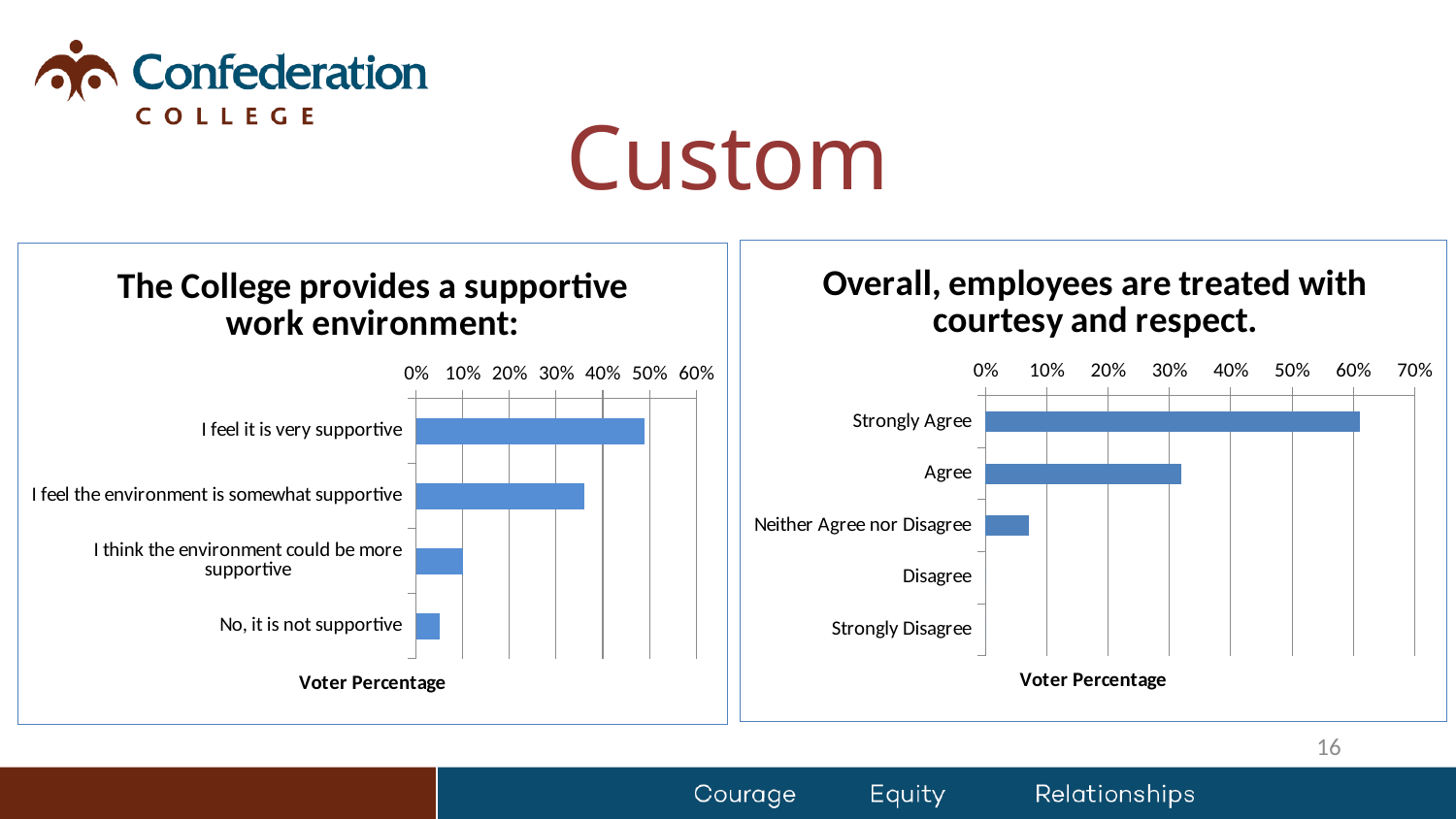
What kind of chart is the chart titled "The College provides a supportive work environment:"? bar chart In the chart titled "Overall, employees are treated with courtesy and respect.", is the value for "Strongly Agree" greater or less than 50%? greater In the chart titled "The College provides a supportive work environment:", which category has the highest value? I feel it is very supportive In the chart titled "Overall, employees are treated with courtesy and respect.", which is larger: "Agree" or "Neither Agree nor Disagree"? Agree In the chart titled "Overall, employees are treated with courtesy and respect.", which category has the highest value? Strongly Agree How many categories are shown in the chart titled "The College provides a supportive work environment:"? 4 How many categories are shown in the chart titled "Overall, employees are treated with courtesy and respect."? 5 In the chart titled "The College provides a supportive work environment:", which is larger: "I feel the environment is somewhat supportive" or "I think the environment could be more supportive"? I feel the environment is somewhat supportive In the chart titled "The College provides a supportive work environment:", which category has the lowest value? No, it is not supportive In the chart titled "The College provides a supportive work environment:", is the value for "I feel it is very supportive" greater or less than 40%? greater What is the x-axis label of the chart titled "Overall, employees are treated with courtesy and respect."? Voter Percentage In the chart titled "The College provides a supportive work environment:", is the value for "I think the environment could be more supportive" greater or less than 20%? less